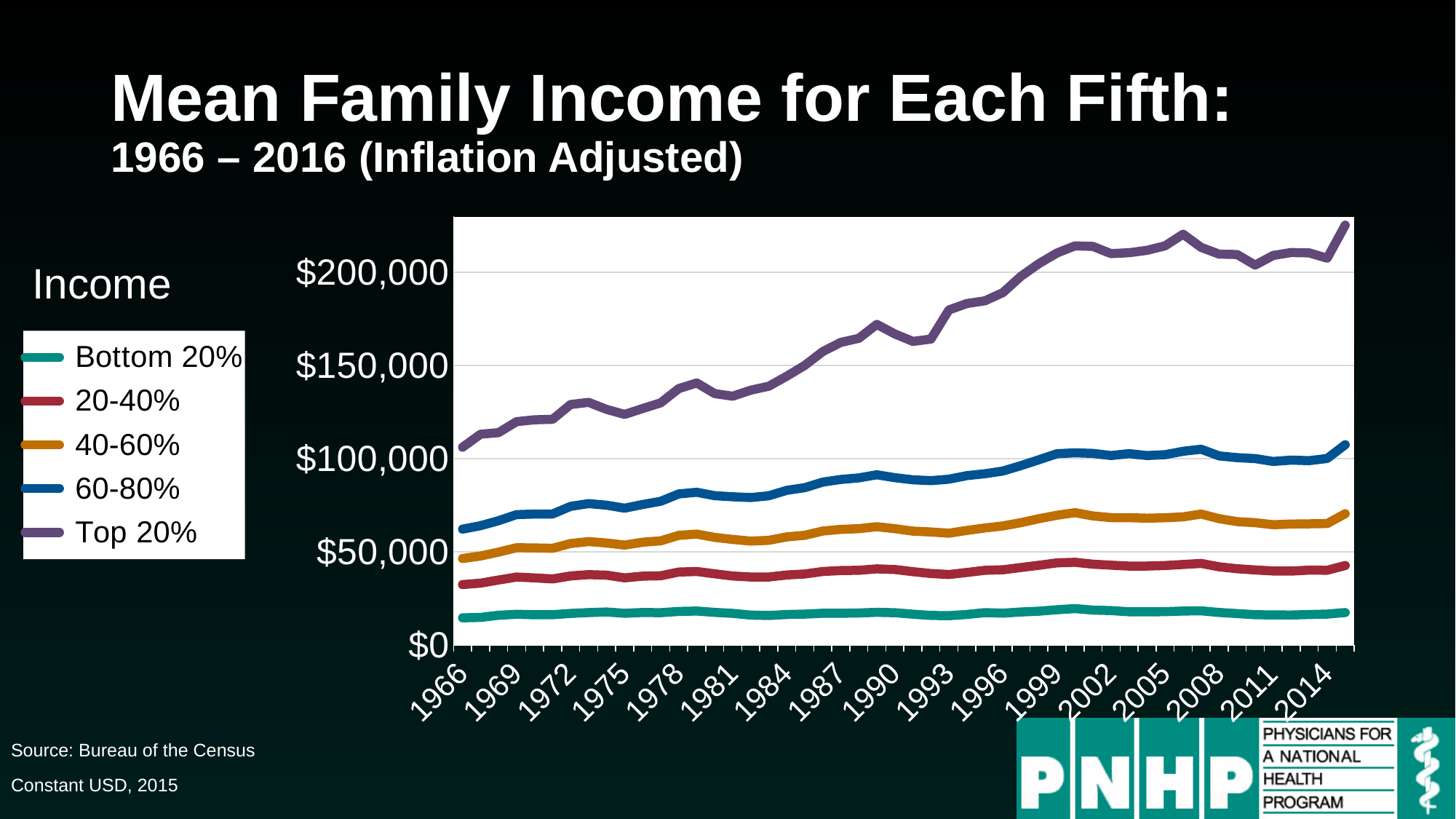
Which income group has the highest mean family income across the whole period? Top 20% Which income group has the lowest mean family income across the whole period? Bottom 20% Which is larger in 2016: the mean family income of the Top 20% or of the 60-80% group? Top 20% How many series does the legend list? 5 Is the value for the 40-60% group in 2016 greater or less than $100,000? less What kind of chart is shown on the slide? Line chart What is the title of the legend on the slide? Income Is the value for the Top 20% in 1966 greater or less than $100,000? greater Is the value for the 20-40% group in 1966 greater or less than $50,000? less Does the mean family income of the Top 20% generally rise or fall from 1966 to 2016? Rise